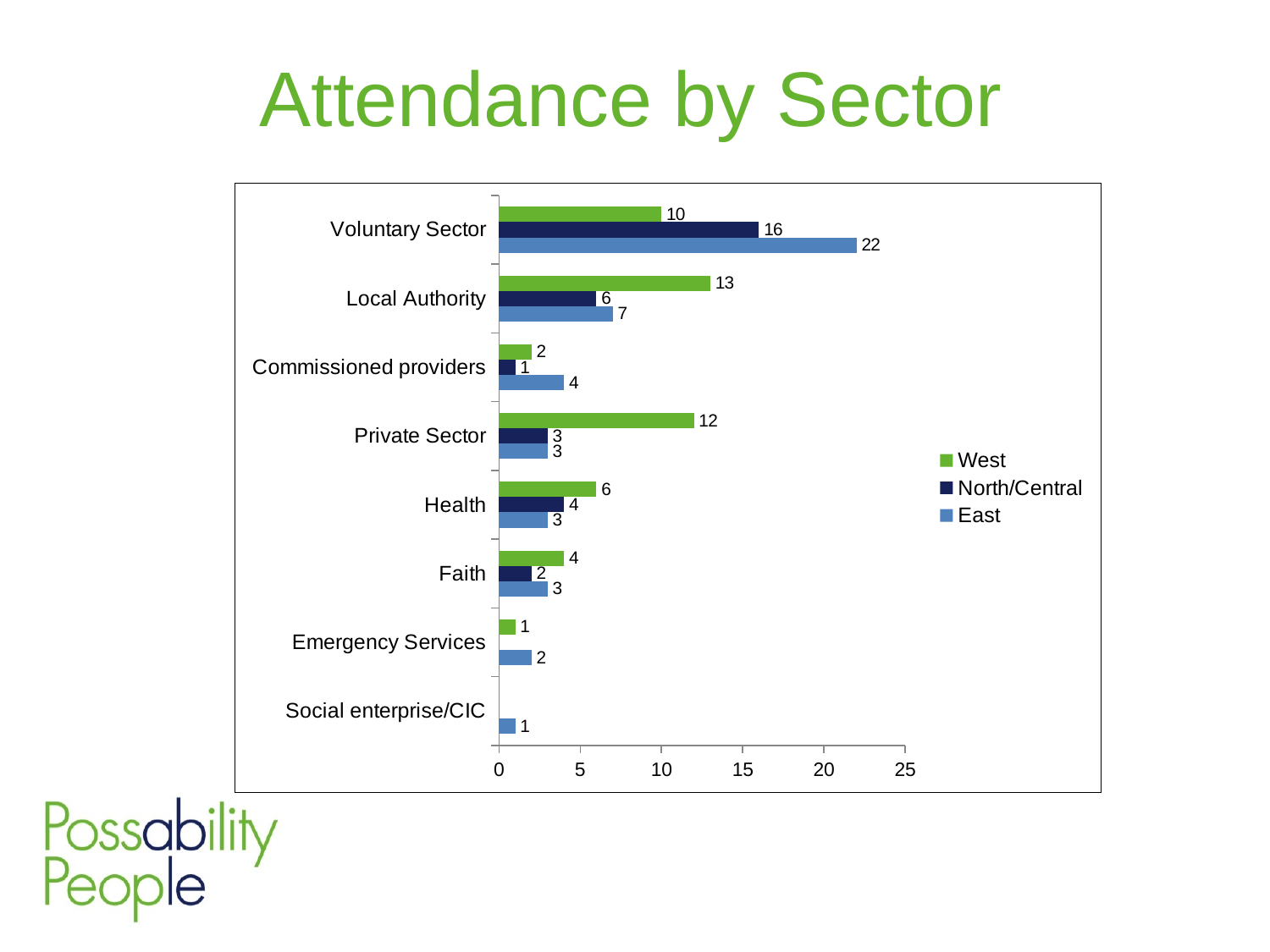
Which sector has the lowest West value among those with a West bar? Emergency Services What is the North/Central value for Health? 4 What is the title of the slide? Attendance by Sector How many sectors are shown on the chart? 8 Which is larger for Private Sector, the West value or the East value? West What kind of chart is shown? bar chart What is the difference between the East and West values for Voluntary Sector? 12 What is the West value for Local Authority? 13 What is the East value for Voluntary Sector? 22 How many series does the legend list? 3 Which sector has the highest East value? Voluntary Sector Is the North/Central value for Voluntary Sector greater or less than 15? greater